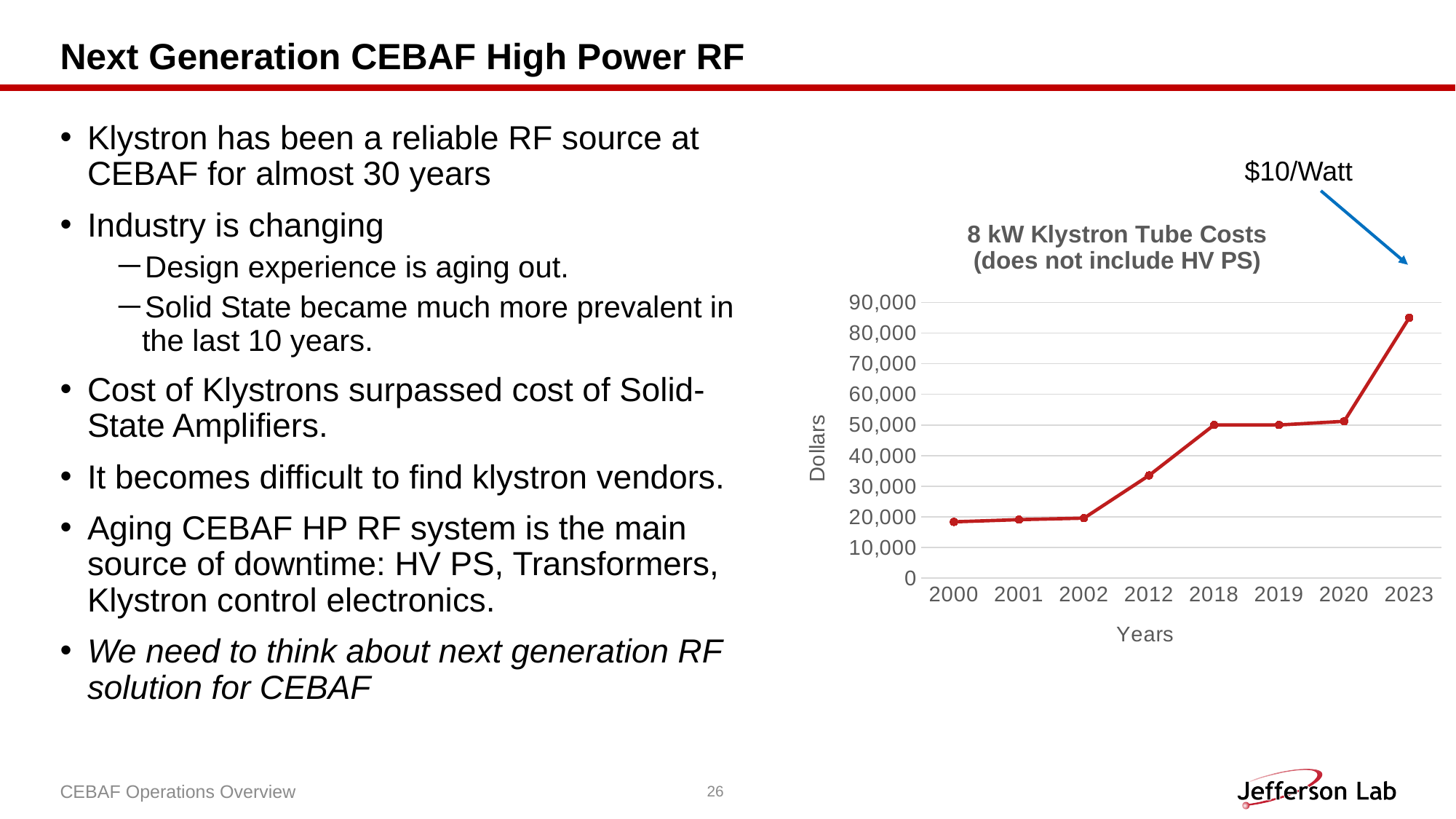
What is the title of the chart? 8 kW Klystron Tube Costs (does not include HV PS) Is the klystron tube cost for 2023 greater or less than 80,000? greater How many years are plotted on the x axis of the chart? 8 Which year has the larger klystron tube cost, 2002 or 2012? 2012 Is the klystron tube cost for 2012 greater or less than 30,000? greater Do the klystron tube costs rise or fall from 2000 to 2023? Rise What is the label of the y axis of the chart? Dollars What kind of chart is shown on the slide? Line chart Is the klystron tube cost for 2000 greater or less than 20,000? less Which year has the larger klystron tube cost, 2018 or 2023? 2023 Which year has the highest 8 kW klystron tube cost? 2023